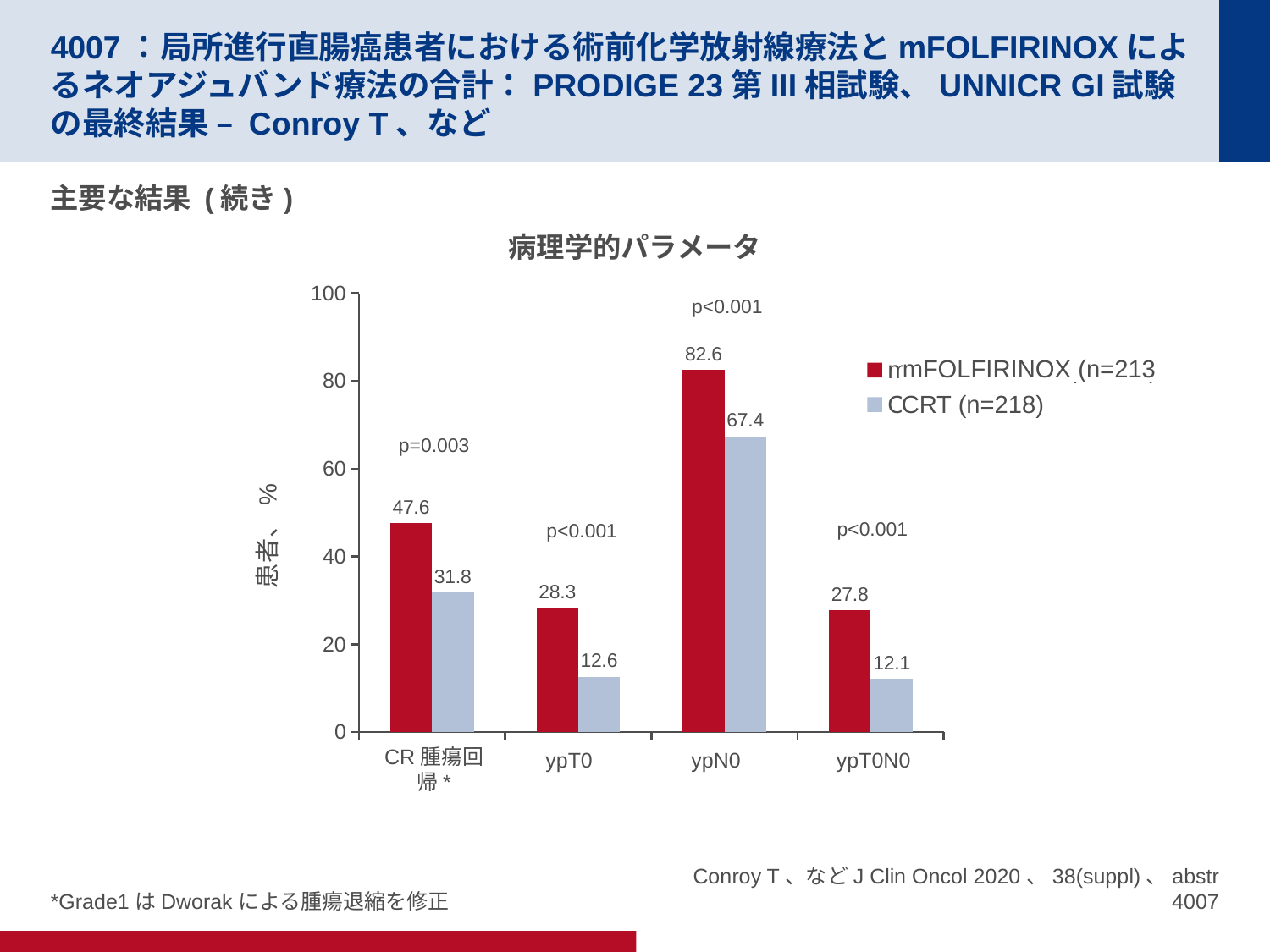
Which is larger in the ypT0 category, the mFOLFIRINOX value or the CCRT value? mFOLFIRINOX What is the value for CCRT in the ypT0 category? 12.6 What is the value for mFOLFIRINOX in the ypT0N0 category? 27.8 What is the value for mFOLFIRINOX in the ypN0 category? 82.6 What p-value is shown above the CR 腫瘍回帰* category? p=0.003 In which category does the mFOLFIRINOX series reach its highest value? ypN0 How many categories are shown on the x axis? 4 What type of chart is shown on the slide? bar chart What is the difference between the mFOLFIRINOX and CCRT values in the ypN0 category? 15.2 How many series does the legend list? 2 What is the value for CCRT in the CR 腫瘍回帰* category? 31.8 In which category does the CCRT series have its lowest value? ypT0N0